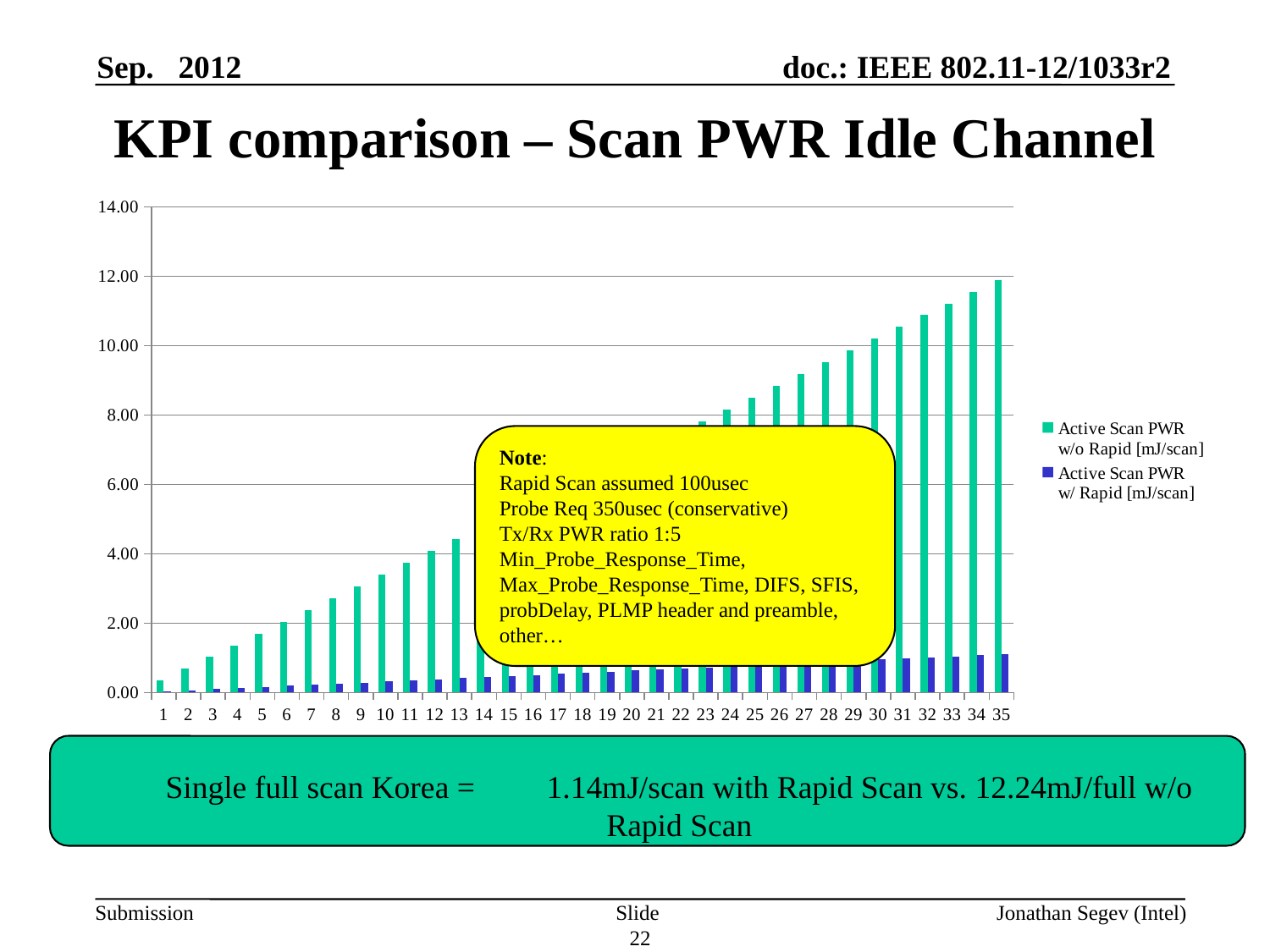
Which category has the highest value for Active Scan PWR w/o Rapid [mJ/scan]? 35 Is the value for Active Scan PWR w/o Rapid [mJ/scan] at category 35 greater or less than 10.00? greater How many categories are shown along the x axis? 35 Is the value for Active Scan PWR w/o Rapid [mJ/scan] at category 5 greater or less than 2.00? less What is the title of the chart slide? KPI comparison – Scan PWR Idle Channel Do the values for Active Scan PWR w/o Rapid [mJ/scan] rise or fall as the x axis goes from 1 to 35? rise Is the value for Active Scan PWR w/o Rapid [mJ/scan] at category 10 greater or less than 4.00? less What kind of chart is shown on the slide? bar chart How many series does the legend list? 2 Which category has the lowest value for Active Scan PWR w/o Rapid [mJ/scan]? 1 At category 35, which series has the larger value: Active Scan PWR w/o Rapid [mJ/scan] or Active Scan PWR w/ Rapid [mJ/scan]? Active Scan PWR w/o Rapid [mJ/scan]